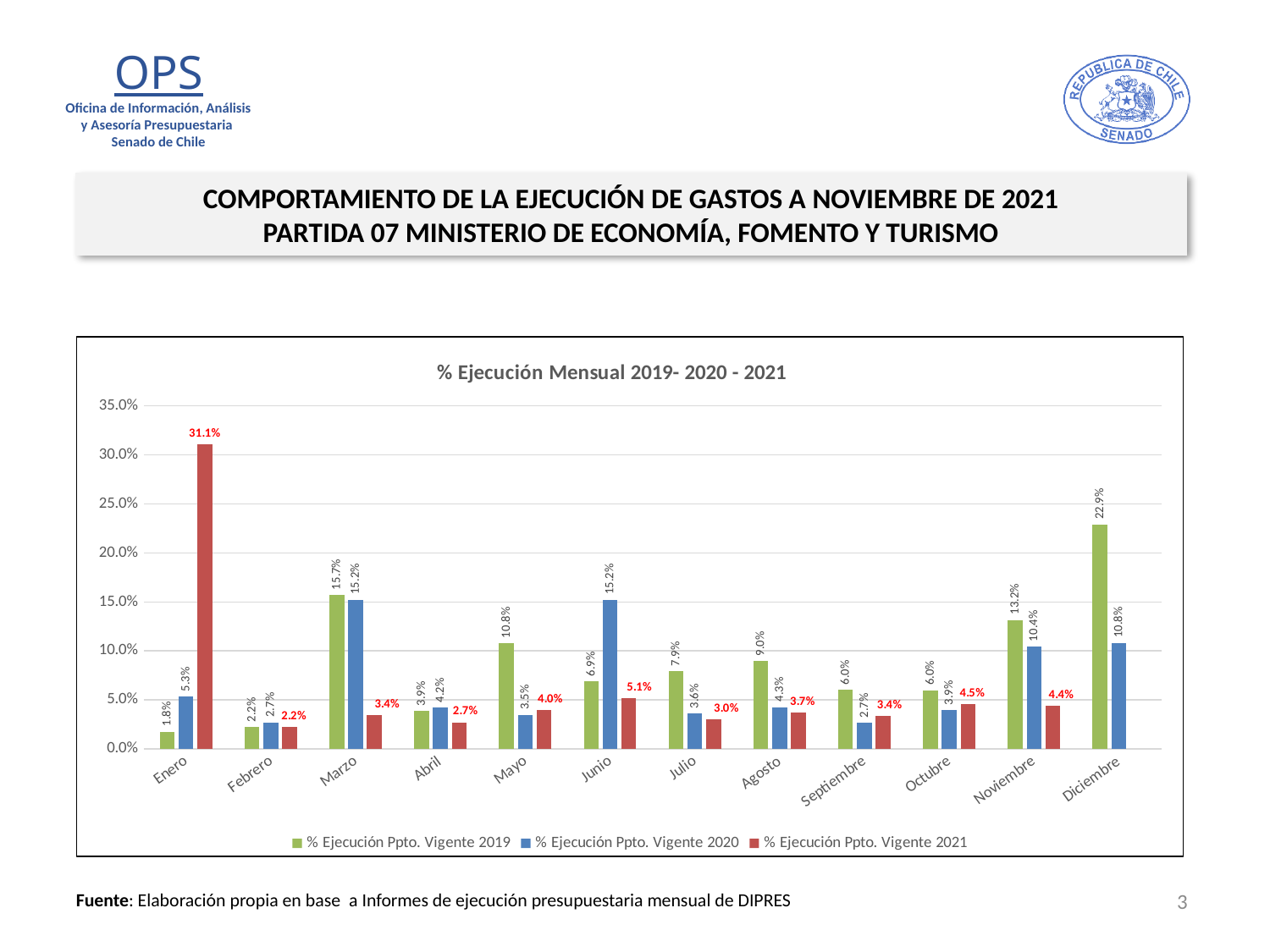
Which month has the highest value in the % Ejecución Ppto. Vigente 2021 series? Enero What is the value for Junio in the % Ejecución Ppto. Vigente 2020 series? 15.2% What is the difference between the 2019 and 2020 values for Noviembre? 2.8% What is the title of the chart? % Ejecución Mensual 2019- 2020 - 2021 Which month has the lowest value in the % Ejecución Ppto. Vigente 2019 series? Enero For Mayo, which is larger: the 2019 value or the 2020 value? 2019 What is the value for Diciembre in the % Ejecución Ppto. Vigente 2019 series? 22.9% How many months are shown on the x axis? 12 What kind of chart is shown on the slide? Bar chart Is the value for Marzo in the 2019 series greater or less than 15.0%? greater How many series does the legend list? 3 What is the value for Enero in the % Ejecución Ppto. Vigente 2021 series? 31.1%